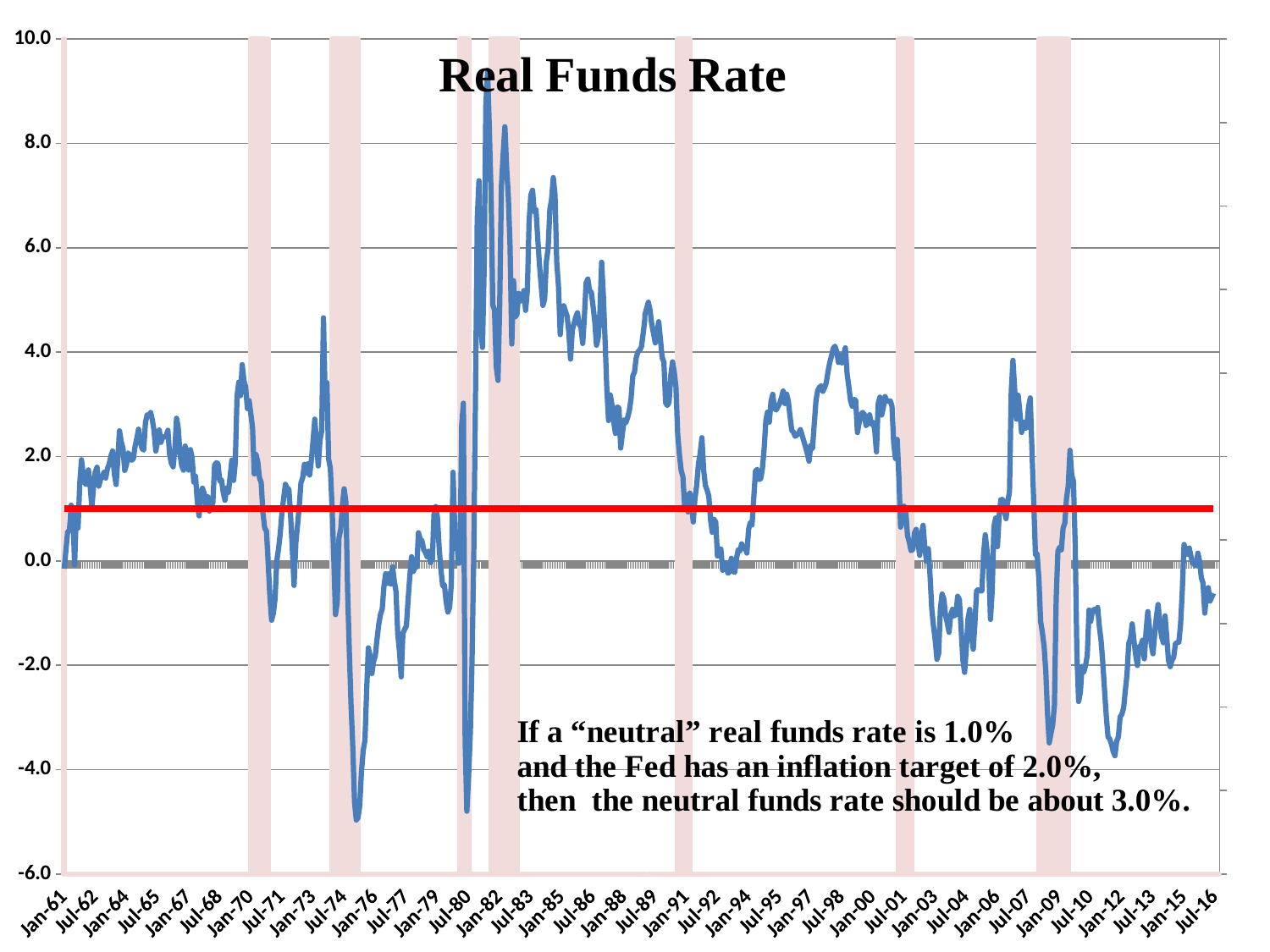
Is the value of the blue line around Jan-12 greater or less than -2.0? less What kind of chart is shown on the slide? line chart Is the real funds rate higher around Jan-82 or around Jan-98? Jan-82 Between Jan-82 and Jan-92, does the blue line generally rise or fall? fall Is the value of the blue line at Jul-16 greater or less than 0.0? less Is the lowest value reached by the blue line greater or less than -4.0? less What is the title of the chart? Real Funds Rate What is the first date label on the x axis? Jan-61 At what level on the y axis is the solid red horizontal line drawn? 1.0